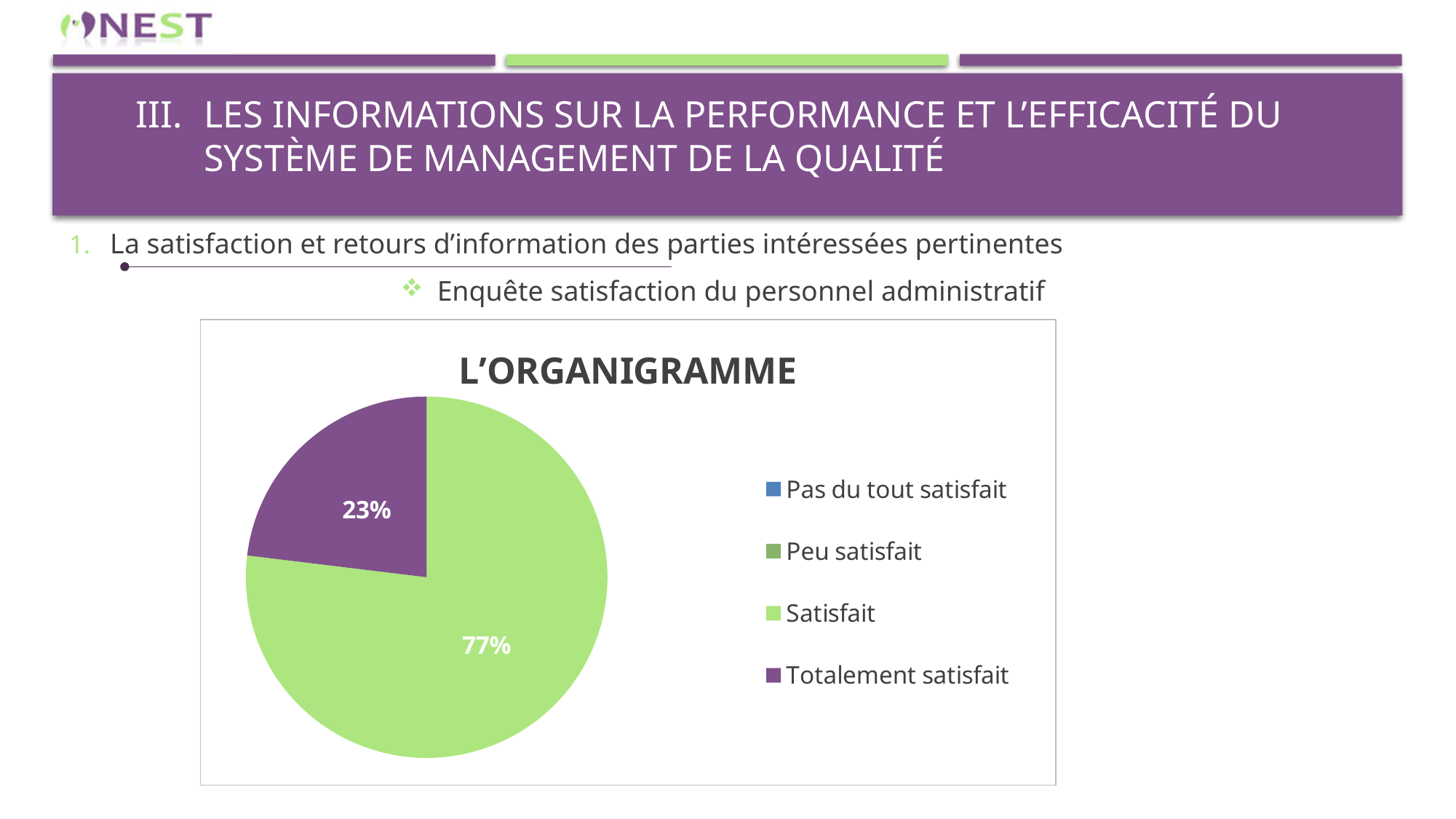
Is the share for "Satisfait" greater or less than 50%? greater Which is larger, the slice for "Satisfait" or the slice for "Totalement satisfait"? Satisfait What is the title of the chart? L'ORGANIGRAMME What share of the pie is labelled "Satisfait"? 77% What colour is the "Satisfait" slice? green Which category has the largest slice of the pie? Satisfait What share of the pie is labelled "Totalement satisfait"? 23% What kind of chart is shown on the slide? pie chart Is the share for "Totalement satisfait" greater or less than 25%? less How many slices are visible in the pie? 2 How many entries does the legend list? 4 What is the difference in percentage points between the "Satisfait" slice and the "Totalement satisfait" slice? 54 percentage points